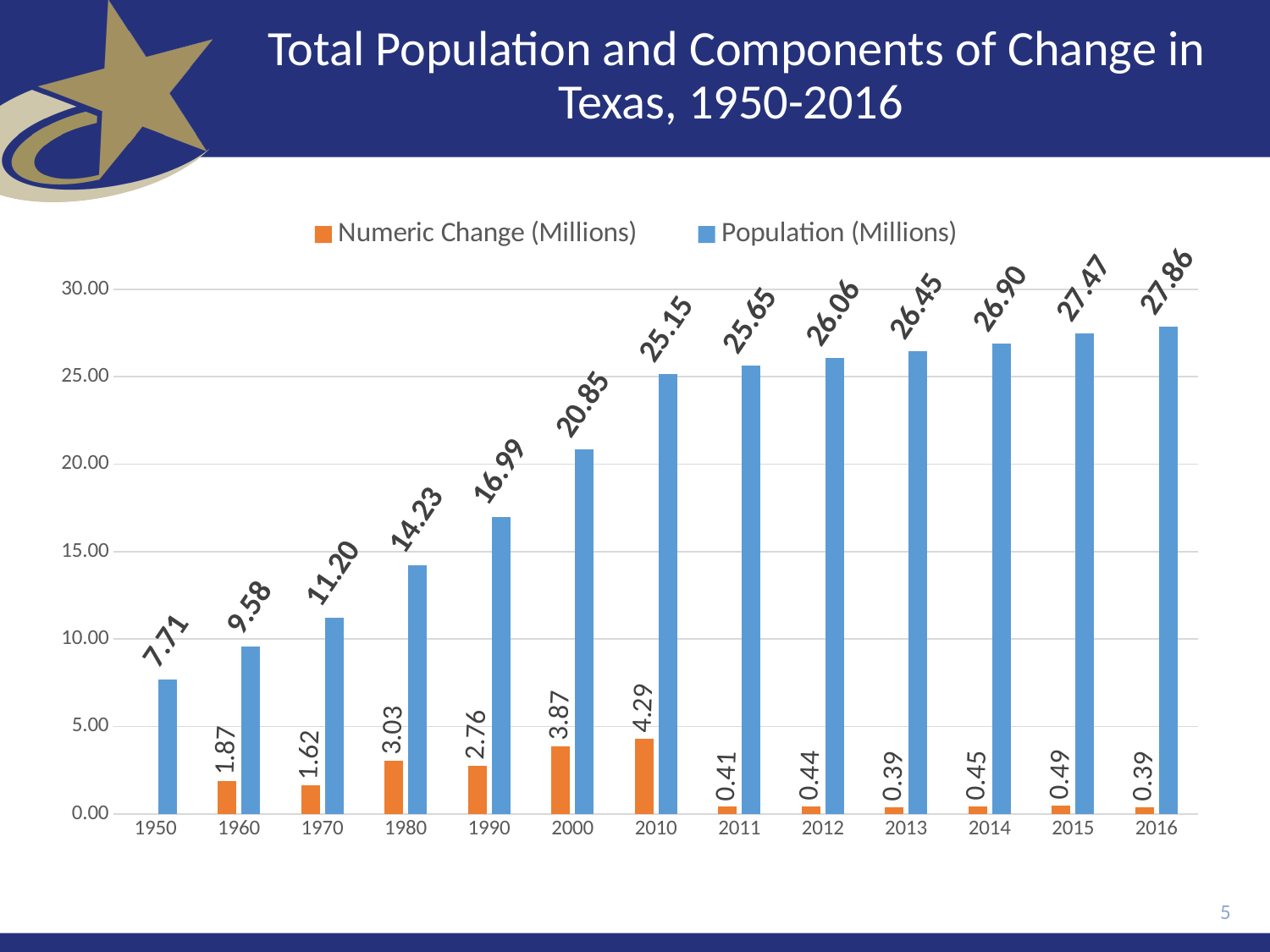
Which year has the lowest Population (Millions)? 1950 Is the Population (Millions) value for 2000 greater or less than 20.00? greater Which is larger, the Numeric Change (Millions) for 1980 or for 1990? 1980 What is the Numeric Change (Millions) value for 2010? 4.29 Does the Population (Millions) series rise or fall from 1950 to 2016? rise What is the Population (Millions) value for 1950? 7.71 Which year has the highest Numeric Change (Millions)? 2010 What kind of chart is shown on the slide? bar chart How many years are shown on the x axis? 13 What is the difference between the Population (Millions) values for 2016 and 2015? 0.39 What is the Population (Millions) value for 2016? 27.86 How many series does the legend list? 2